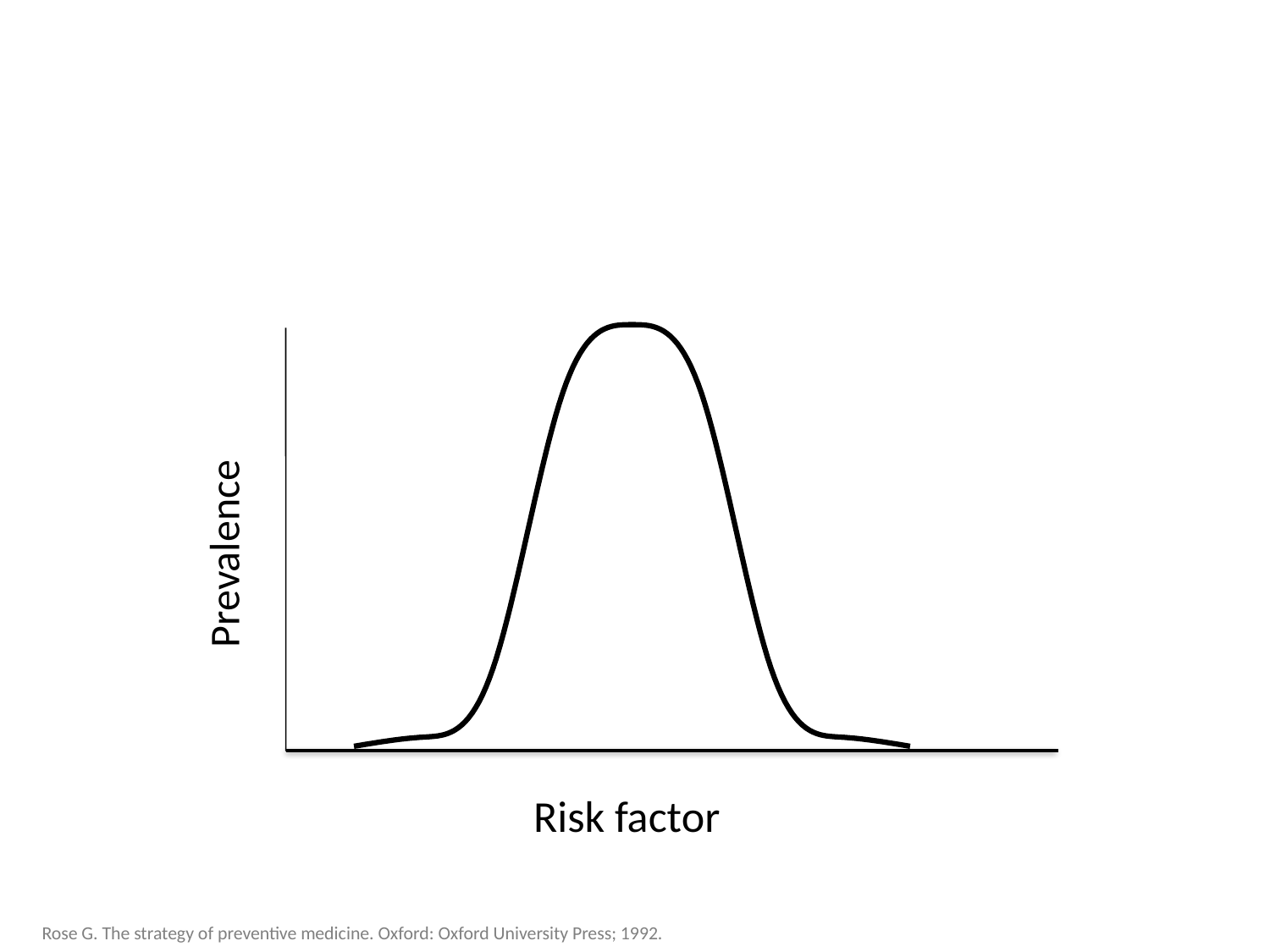
What is the label of the x axis? Risk factor How does the curve behave as the risk factor increases along the x axis? rises to a peak in the middle, then falls How many curves are plotted on the chart? 1 What is the label of the y axis? Prevalence What kind of chart is shown on the slide? line chart Is prevalence higher at the middle of the risk factor range or at the extremes? middle